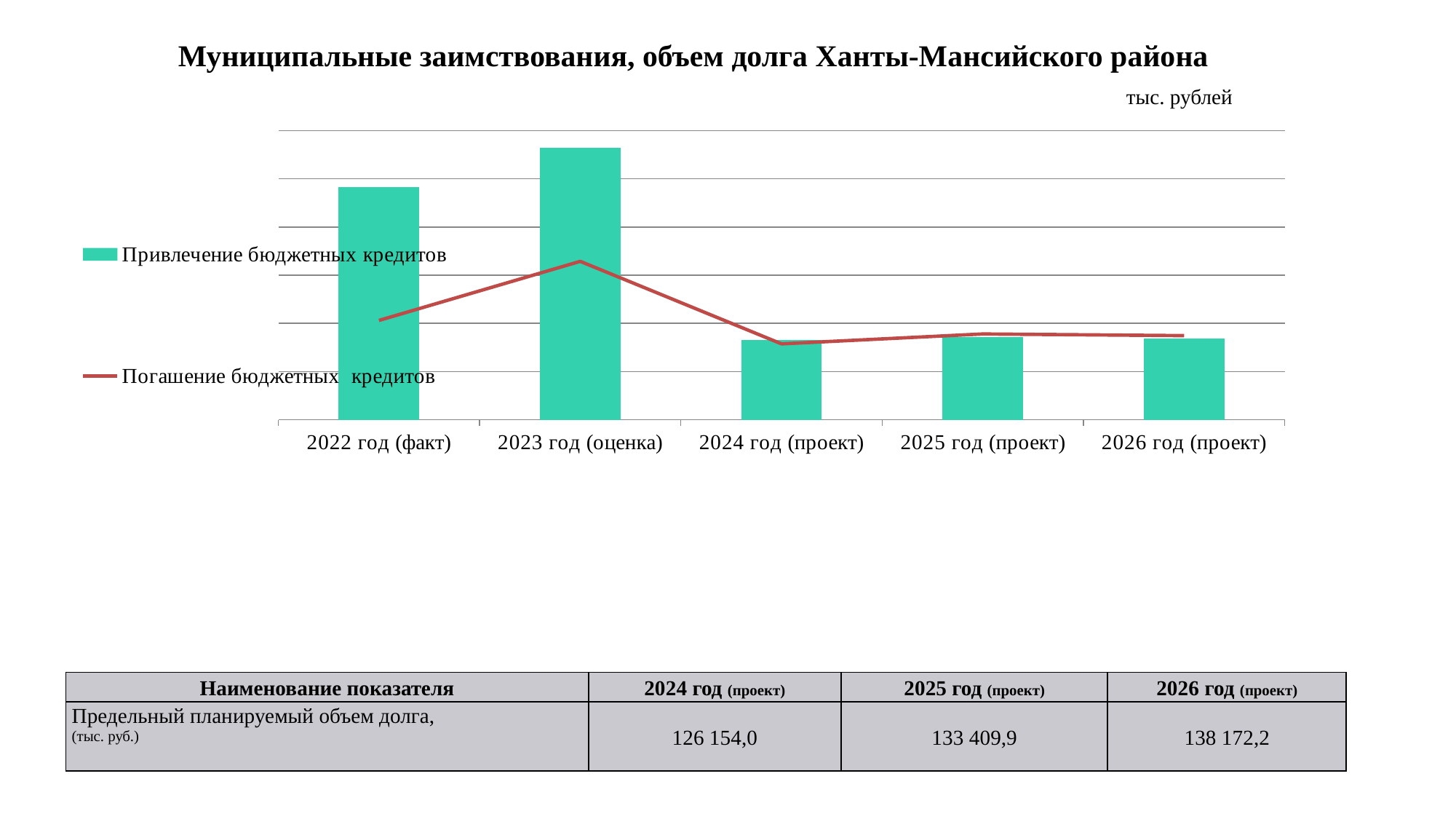
How many series does the chart legend list? 2 What unit is indicated above the chart? тыс. рублей Which year has the highest bar for Привлечение бюджетных кредитов? 2023 год (оценка) What kind of chart is shown on the slide? Combined bar and line chart Which is higher on the Погашение бюджетных кредитов line: 2022 год (факт) or 2024 год (проект)? 2022 год (факт) Which is larger for Привлечение бюджетных кредитов: 2022 год (факт) or 2024 год (проект)? 2022 год (факт) Does the Погашение бюджетных кредитов line rise or fall from 2022 год (факт) to 2023 год (оценка)? Rise Which series is shown as a red line in the chart? Погашение бюджетных кредитов How many categories (years) are shown on the x axis of the chart? 5 In which year does the line for Погашение бюджетных кредитов reach its highest point? 2023 год (оценка) Which is larger for Привлечение бюджетных кредитов: 2022 год (факт) or 2023 год (оценка)? 2023 год (оценка) Does the Привлечение бюджетных кредитов bar rise or fall from 2023 год (оценка) to 2024 год (проект)? Fall